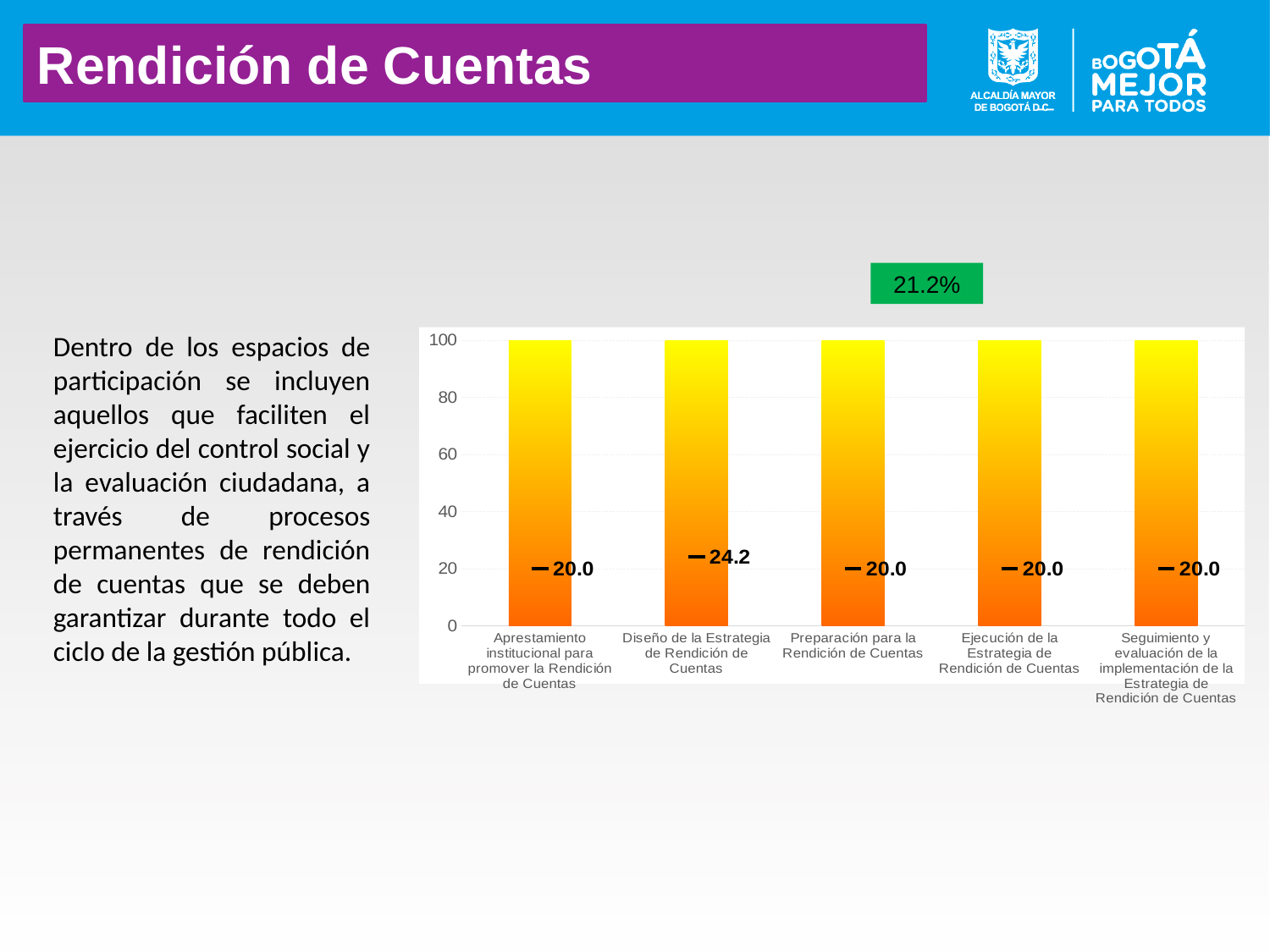
What value is labelled on the marker for "Aprestamiento institucional para promover la Rendición de Cuentas"? 20.0 Is the height of the bar for "Ejecución de la Estrategia de Rendición de Cuentas" greater or less than 80? greater What percentage is shown in the green box above the chart? 21.2% Which category has the highest labelled marker value? Diseño de la Estrategia de Rendición de Cuentas Which has the larger labelled marker value: "Diseño de la Estrategia de Rendición de Cuentas" or "Preparación para la Rendición de Cuentas"? Diseño de la Estrategia de Rendición de Cuentas What kind of chart is shown on the slide? Bar chart How many categories are shown on the x axis of the chart? 5 What value is labelled on the marker for "Diseño de la Estrategia de Rendición de Cuentas"? 24.2 What is the difference between the labelled marker values for "Diseño de la Estrategia de Rendición de Cuentas" and "Ejecución de la Estrategia de Rendición de Cuentas"? 4.2 What is the highest value shown on the vertical axis of the chart? 100 What value is labelled on the marker for "Preparación para la Rendición de Cuentas"? 20.0 What value is labelled on the marker for "Seguimiento y evaluación de la implementación de la Estrategia de Rendición de Cuentas"? 20.0